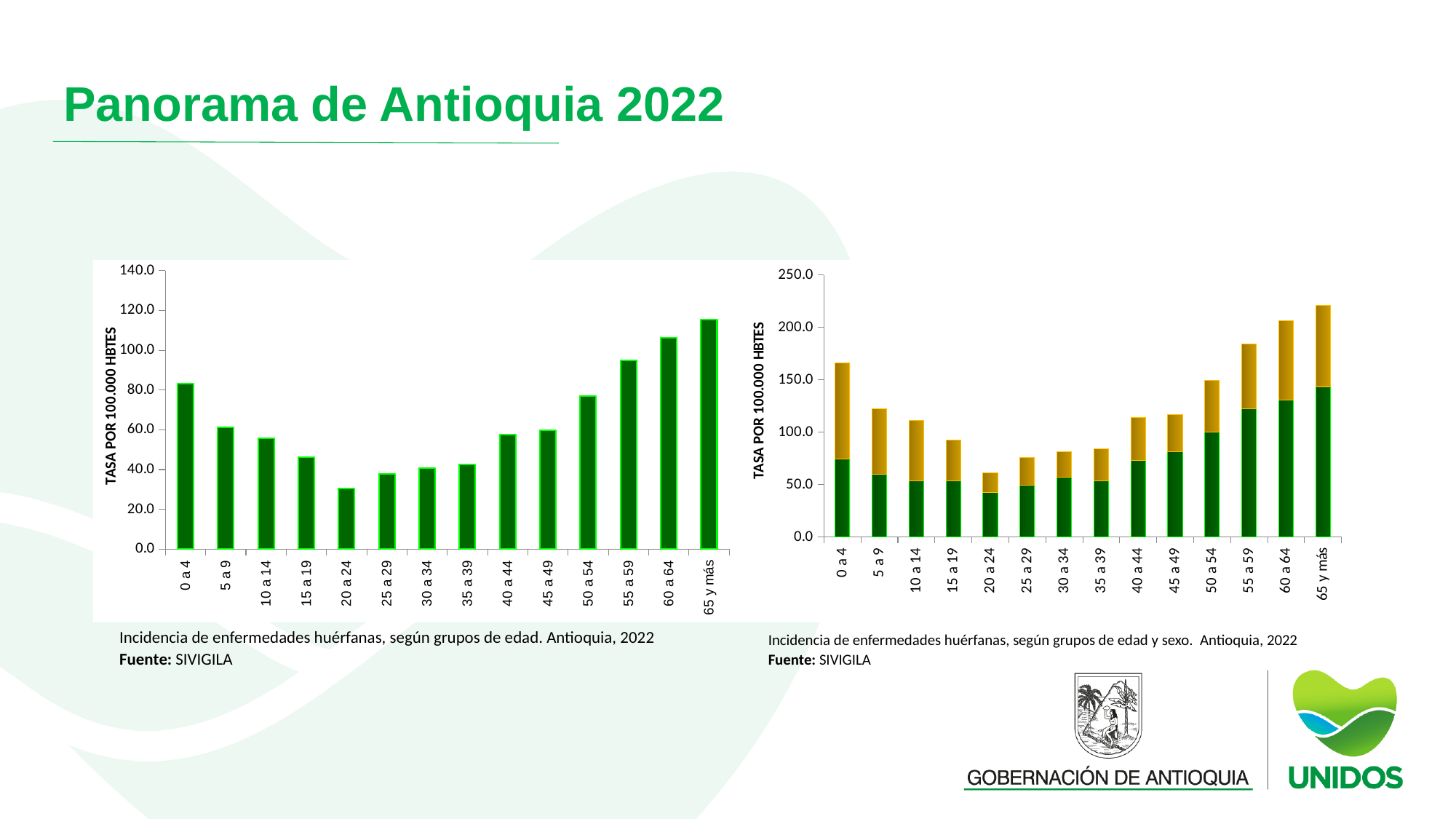
In the right chart (según grupos de edad y sexo), which age group has the highest total stacked bar? 65 y más In the left chart (según grupos de edad), which age group has the lowest rate? 20 a 24 In the right chart (según grupos de edad y sexo), is the total for 65 y más greater or less than 200.0? greater What kind of chart is the left chart (Incidencia de enfermedades huérfanas, según grupos de edad)? Bar chart In the left chart (según grupos de edad), is the value for 65 y más greater or less than 100.0? greater What is the y-axis label of the left chart (según grupos de edad)? TASA POR 100.000 HBTES In the left chart (según grupos de edad), which is larger, the value for 0 a 4 or the value for 5 a 9? 0 a 4 In the left chart (según grupos de edad), which age group has the highest rate? 65 y más In the left chart (según grupos de edad), is the value for 20 a 24 greater or less than 40.0? less In the left chart (según grupos de edad), how many age groups are shown on the x axis? 14 In the right chart (según grupos de edad y sexo), which age group has the lowest total stacked bar? 20 a 24 In the left chart (según grupos de edad), do the values rise or fall from 20 a 24 to 65 y más? Rise